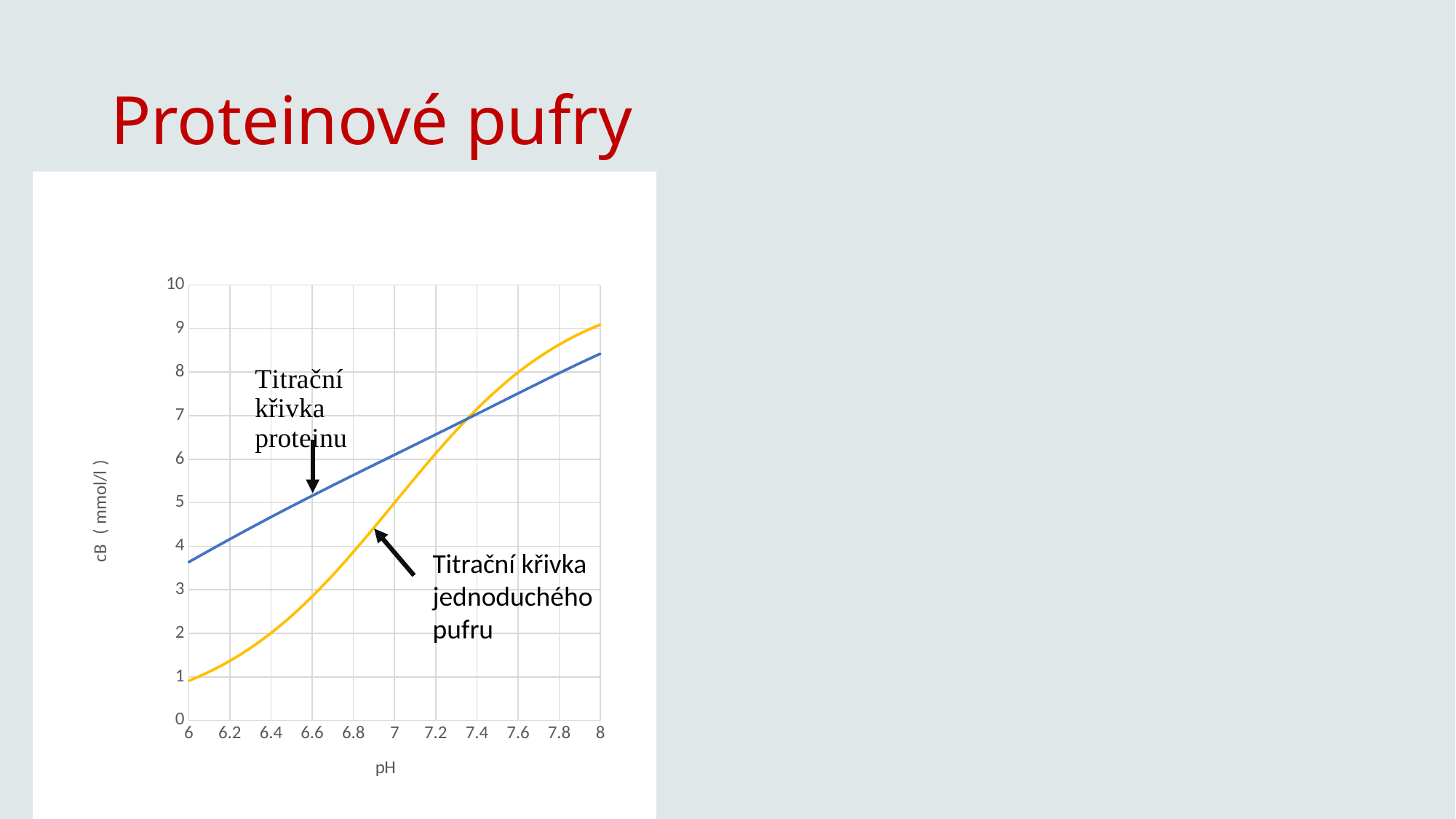
What is the label of the y axis of the chart? cB ( mmol/l ) Is the value of 'Titrační křivka jednoduchého pufru' at pH 6 greater or less than 2? less What is the label of the x axis of the chart? pH Is the value of 'Titrační křivka proteinu' at pH 8 greater or less than 8? greater Is the value of 'Titrační křivka proteinu' at pH 6 greater or less than 3? greater Does the curve labelled 'Titrační křivka proteinu' rise or fall as pH increases from 6 to 8? rise What kind of chart is shown on the slide? line chart How many curves are plotted on the chart? 2 At pH 6, which curve has the higher cB value, 'Titrační křivka proteinu' or 'Titrační křivka jednoduchého pufru'? Titrační křivka proteinu At pH 8, which curve has the higher cB value, 'Titrační křivka proteinu' or 'Titrační křivka jednoduchého pufru'? Titrační křivka jednoduchého pufru Does the curve labelled 'Titrační křivka jednoduchého pufru' rise or fall as pH increases from 6 to 8? rise